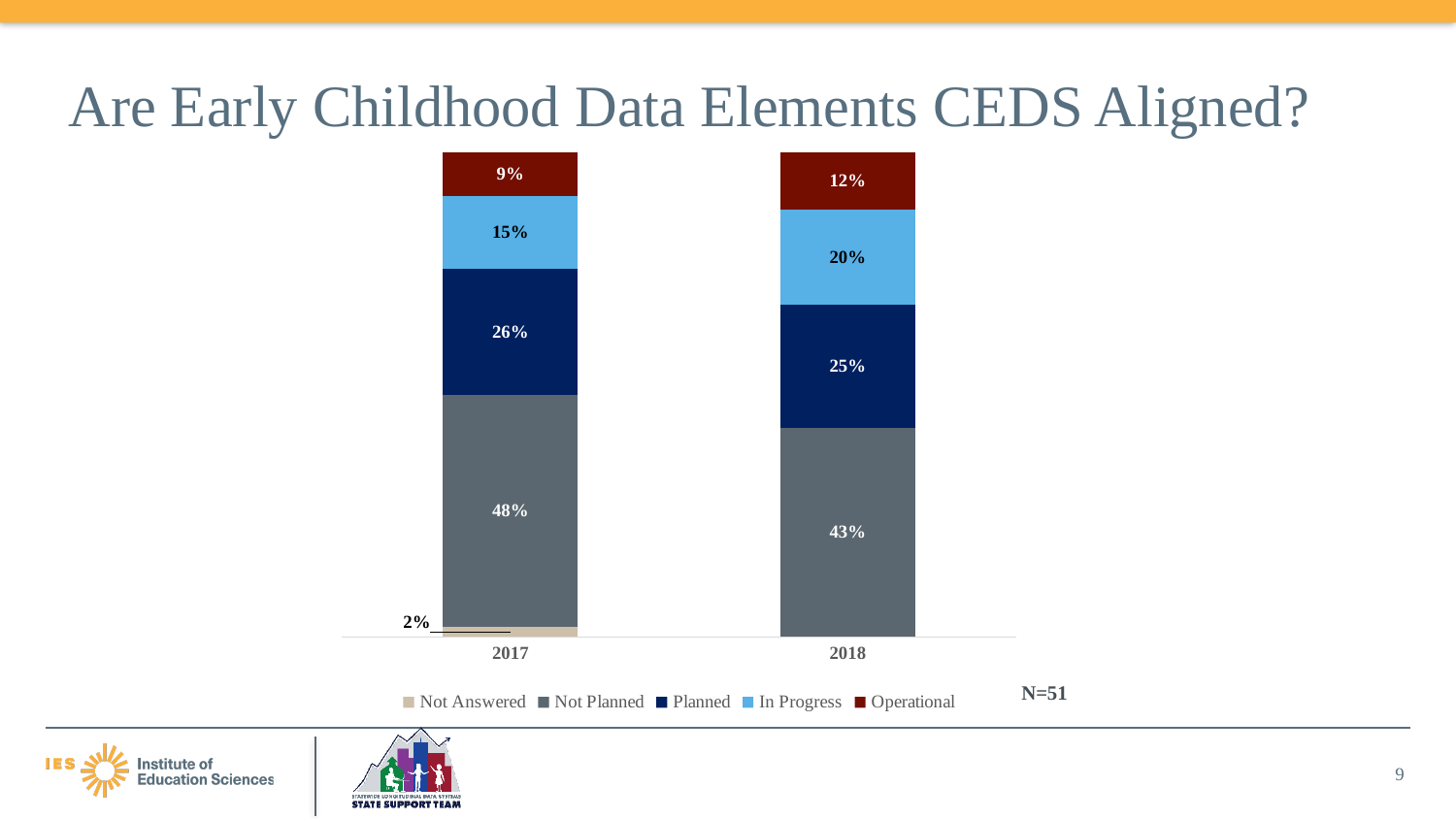
What is the Not Answered value for 2017? 2% What is the difference between the Planned values for 2017 and 2018? 1% What kind of chart is shown on the slide? Stacked bar chart What is the total of the 2017 stacked bar? 100% Which series has the smallest segment in the 2017 bar? Not Answered What is the Operational value for 2018? 12% How many years are shown on the x axis? 2 Is the Operational value larger in 2017 or 2018? 2018 What is the Not Planned value for 2017? 48% What is the In Progress value for 2018? 20% Which series has the largest segment in the 2018 bar? Not Planned How many series does the legend list? 5